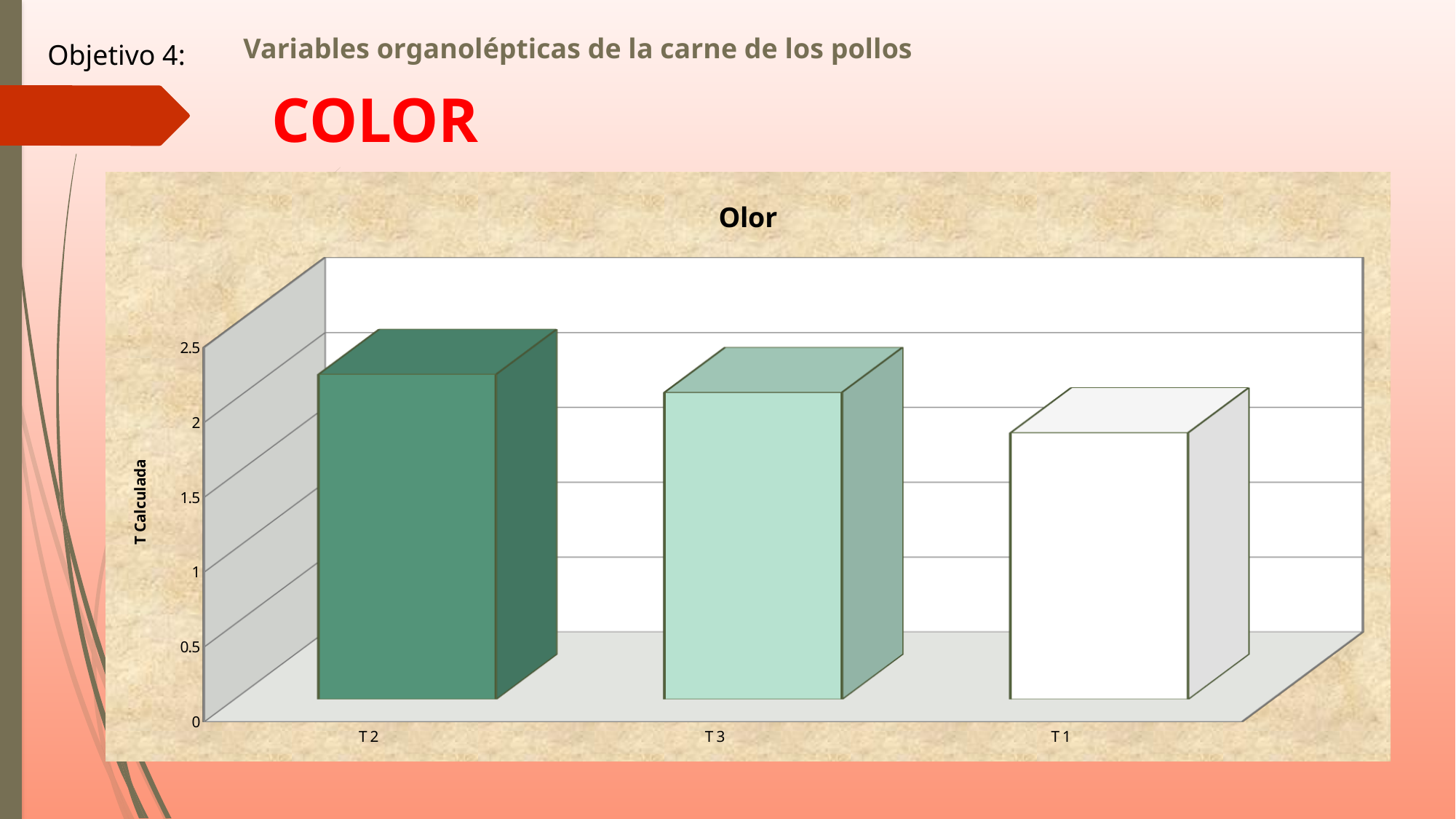
What is the label on the vertical axis of the chart? T Calculada Is the value for T 1 greater or less than 2? less Which category has the highest value in the chart? T 2 What is the title of the chart? Olor Do the values rise or fall from left to right across the categories? fall Which has a larger value, T 2 or T 1? T 2 Is the value for T 2 greater or less than 2? greater What kind of chart is shown on the slide? bar chart Which category has the lowest value in the chart? T 1 Is the value for T 1 greater or less than 1.5? greater How many categories are plotted in the chart? 3